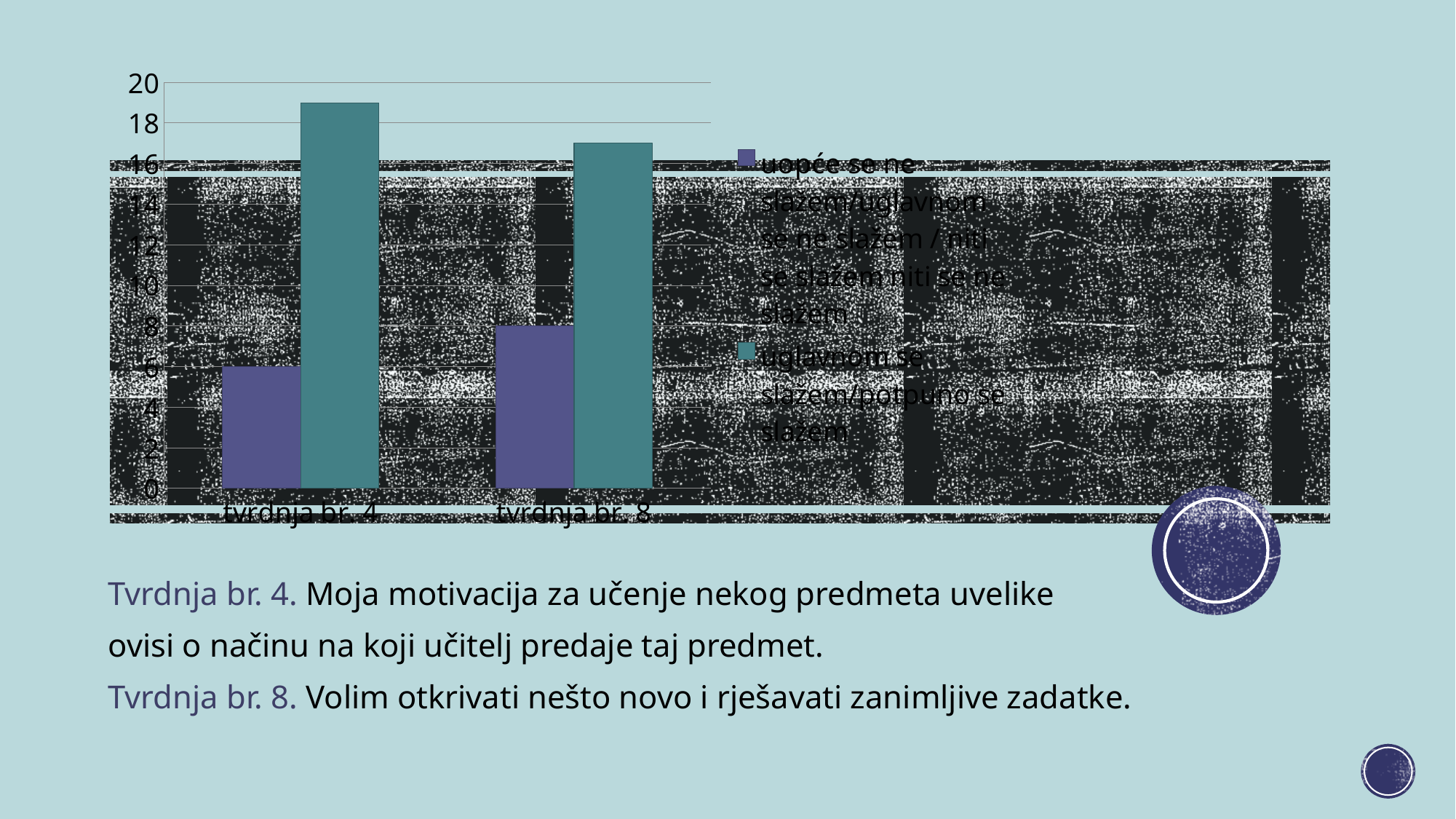
Is the 'uglavnom se slažem/potpuno se slažem' value for tvrdnja br. 8 greater or less than 16? greater How many categories are shown on the x axis of the chart? 2 What is the maximum value shown on the chart's vertical axis? 20 Is the 'uopće se ne slažem/uglavnom se ne slažem / niti se slažem niti se ne slažem' value for tvrdnja br. 8 greater or less than 10? less Is the 'uopće se ne slažem/uglavnom se ne slažem / niti se slažem niti se ne slažem' value for tvrdnja br. 4 greater or less than 10? less Which category has the highest 'uglavnom se slažem/potpuno se slažem' bar? tvrdnja br. 4 How many series does the chart's legend list? 2 What kind of chart is shown on the slide? bar chart Which category has the lowest 'uopće se ne slažem/uglavnom se ne slažem / niti se slažem niti se ne slažem' bar? tvrdnja br. 4 For tvrdnja br. 8, which series has the larger value: 'uglavnom se slažem/potpuno se slažem' or 'uopće se ne slažem/uglavnom se ne slažem / niti se slažem niti se ne slažem'? uglavnom se slažem/potpuno se slažem Which category has the larger 'uglavnom se slažem/potpuno se slažem' value, tvrdnja br. 4 or tvrdnja br. 8? tvrdnja br. 4